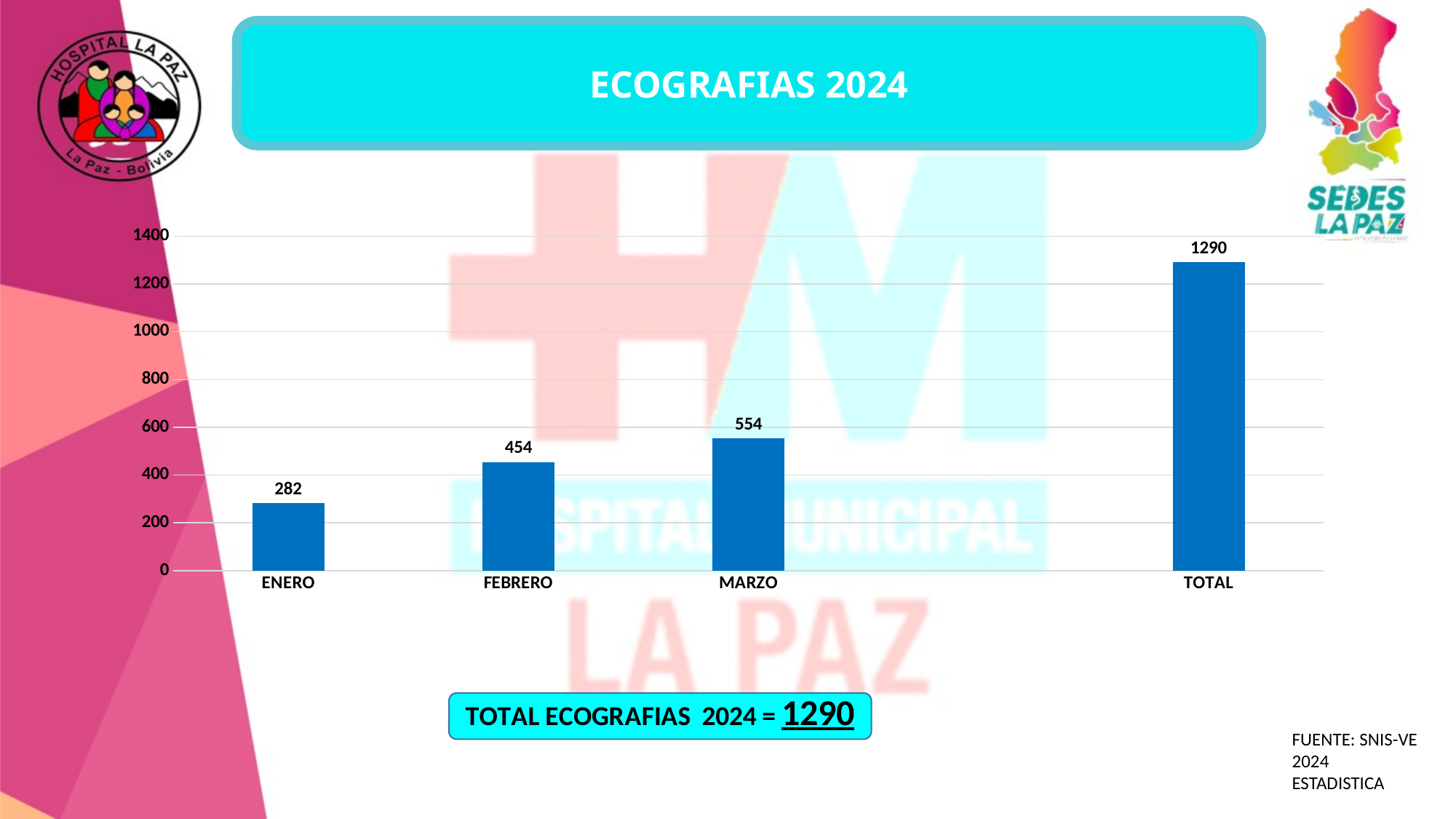
What is the value for TOTAL? 1290 Which month has the highest value among ENERO, FEBRERO and MARZO? MARZO Which is larger, the value for FEBRERO or the value for MARZO? MARZO What is the value for ENERO? 282 How many bars are shown in the chart? 4 What is the value for MARZO? 554 What is the difference between the values for MARZO and ENERO? 272 Is the value for FEBRERO greater or less than 400? greater What kind of chart is shown on the slide? bar chart Do the values rise or fall from ENERO to MARZO? rise Which category has the lowest value? ENERO What is the value for FEBRERO? 454